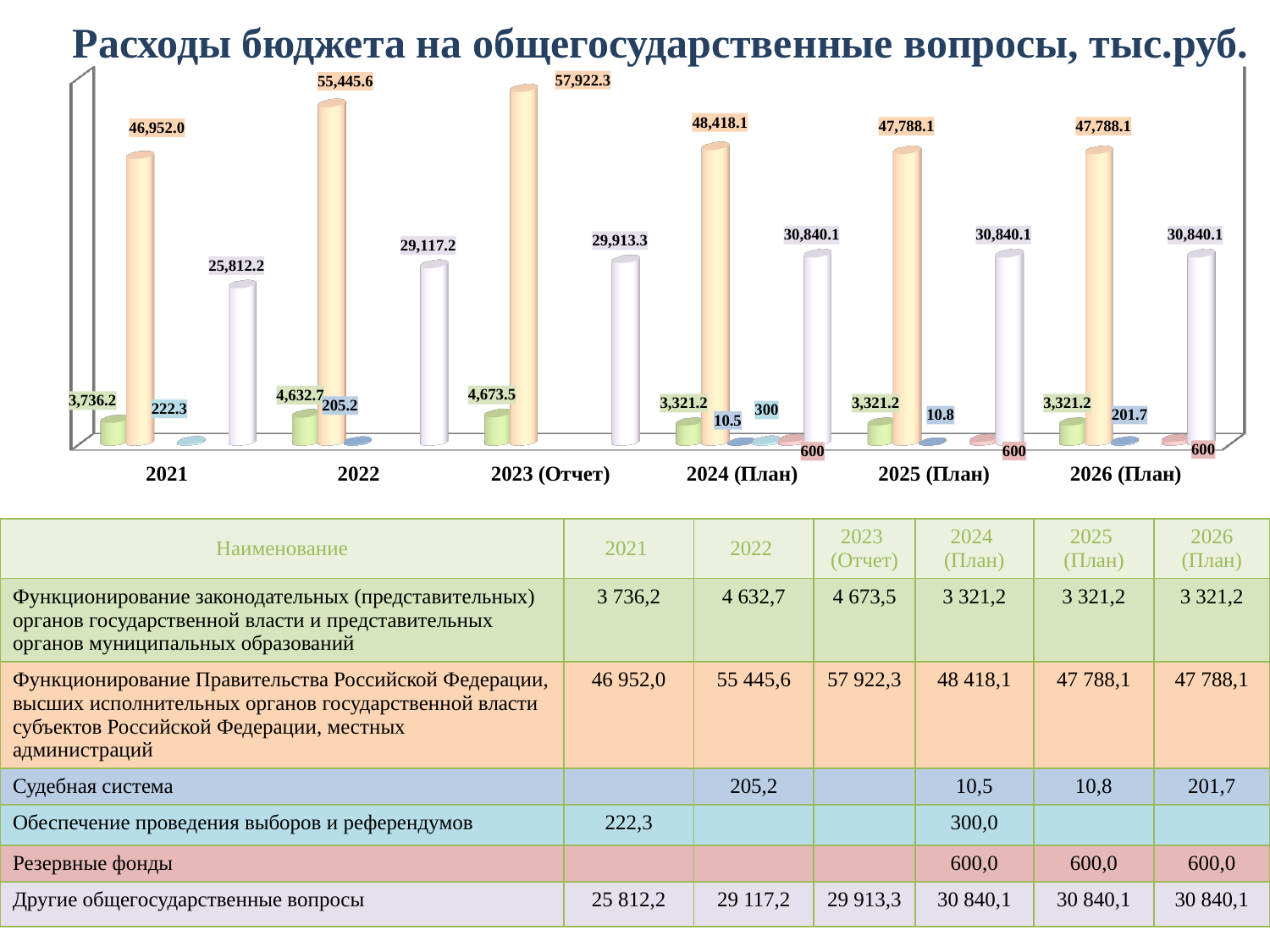
Which is larger: the tallest bar in 2024 (План) or the tallest bar in 2025 (План)? 2024 (План) What is the difference between the white bar values for 2024 (План) (30,840.1) and 2023 (Отчет) (29,913.3)? 926.8 In which year category does the tallest bar of the whole chart appear? 2023 (Отчет) What is the value labelled for the white bar (Другие общегосударственные вопросы) in 2022? 29,117.2 What is the difference between the tallest bar in 2023 (Отчет) (57,922.3) and the tallest bar in 2022 (55,445.6)? 2,476.7 What is the value of the tallest bar for 2023 (Отчет)? 57,922.3 What type of chart is shown on the slide? bar chart What is the title of the chart? Расходы бюджета на общегосударственные вопросы, тыс.руб. Does the value of the tallest bar rise or fall from 2021 to 2023 (Отчет)? rise How many year categories are shown along the x axis of the chart? 6 What is the value labelled for the green bar (Функционирование законодательных органов) in 2024 (План)? 3,321.2 What is the value of the tallest bar for 2021? 46,952.0